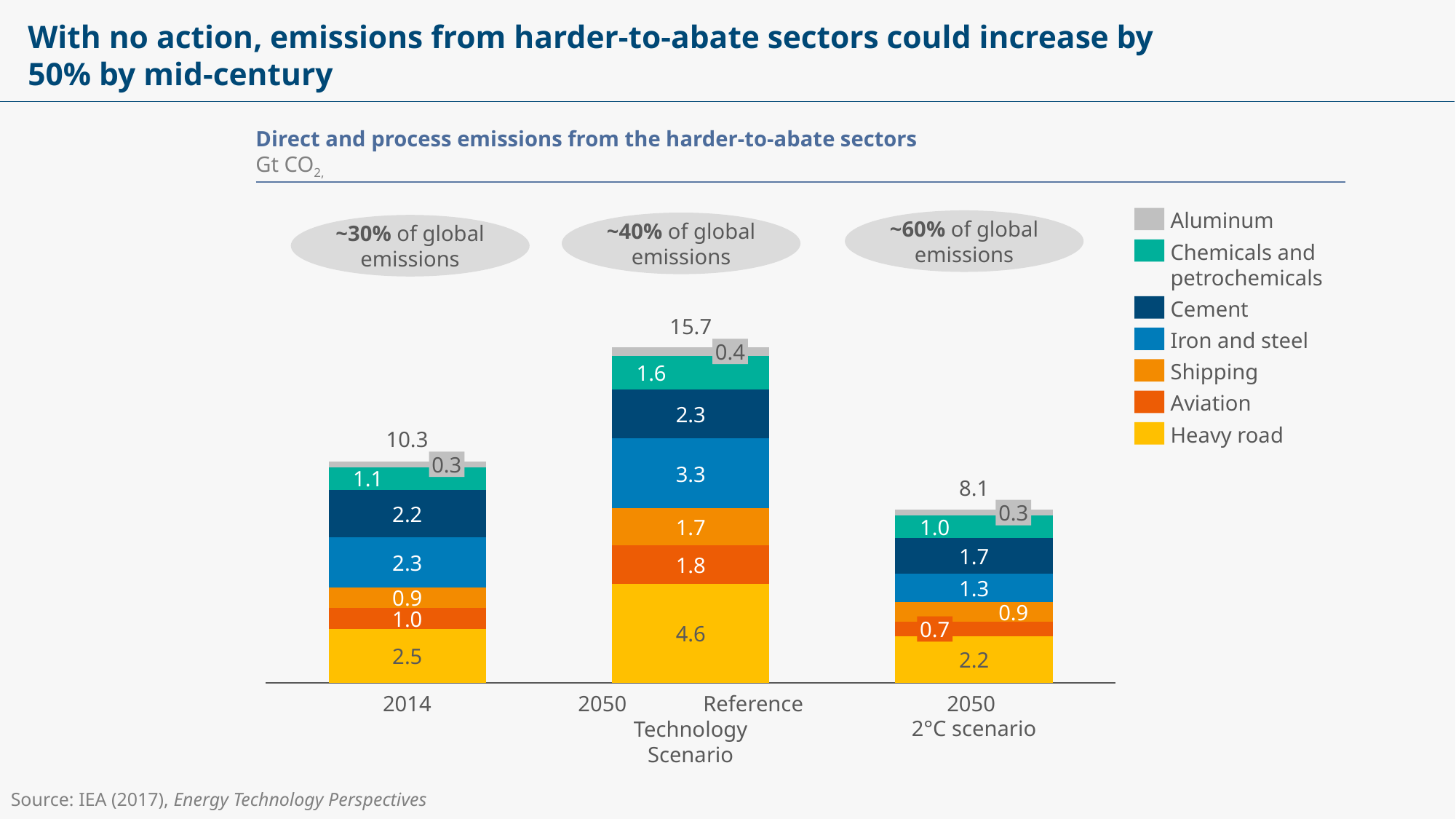
What is the Heavy road value for the 2050 Reference Technology Scenario? 4.6 What kind of chart is shown on the slide? Stacked bar chart Which category has the lowest total emissions? 2050 2°C scenario How many categories are shown on the x axis? 3 Which is larger, the Aviation value for 2014 or the Aviation value for the 2050 Reference Technology Scenario? 2050 Reference Technology Scenario What is the difference between the Iron and steel values for the 2050 Reference Technology Scenario and the 2050 2°C scenario? 2.0 What is the total of the stacked bar for 2014? 10.3 What is the Cement value for the 2050 2°C scenario? 1.7 Which category has the highest total emissions? 2050 Reference Technology Scenario What is the Iron and steel value for 2014? 2.3 How many series does the legend list? 7 What is the total of the stacked bar for the 2050 Reference Technology Scenario? 15.7